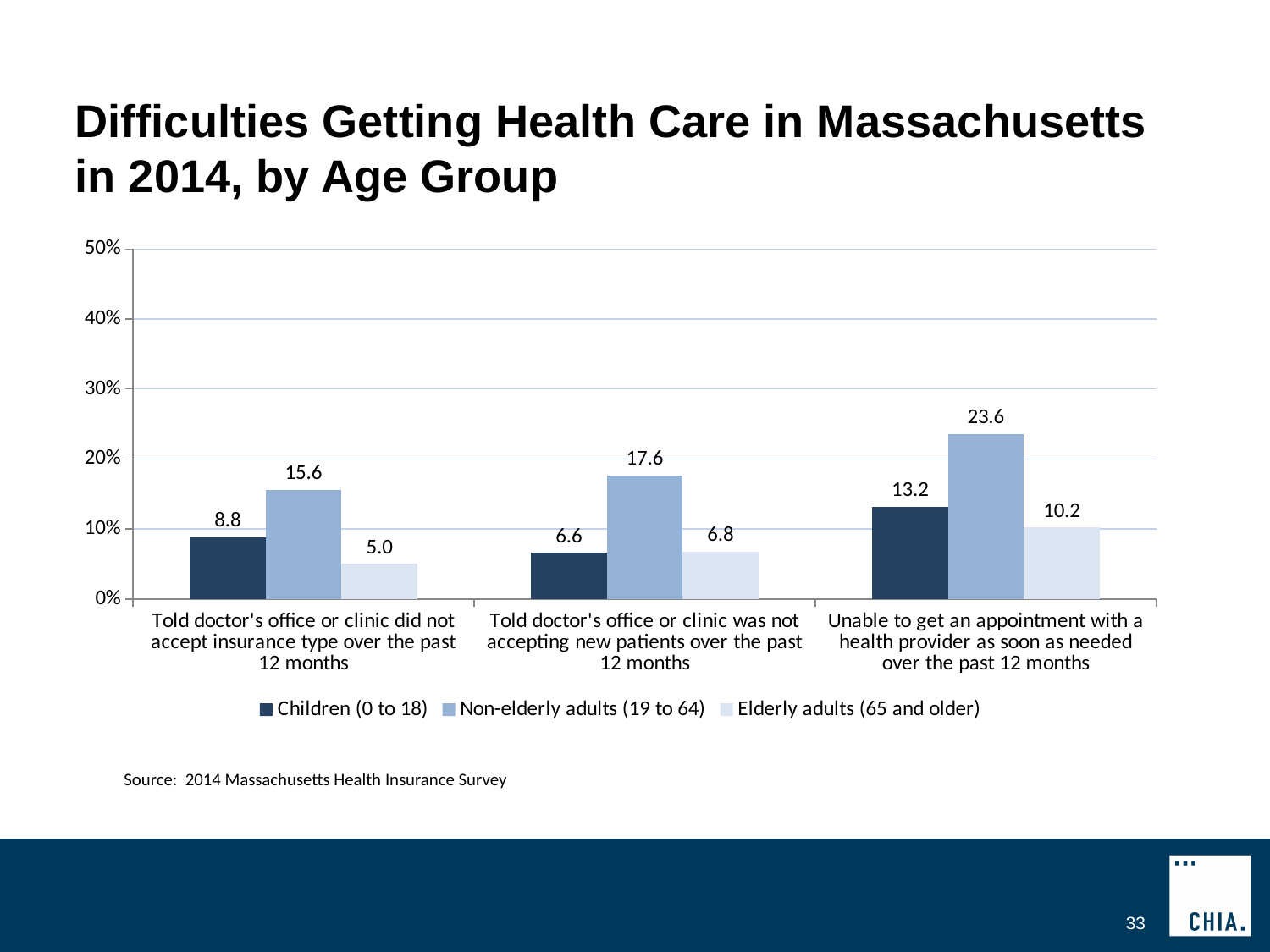
Which age group has the lowest value for 'Told doctor's office or clinic did not accept insurance type over the past 12 months'? Elderly adults (65 and older) Which age group has the highest value for 'Told doctor's office or clinic was not accepting new patients over the past 12 months'? Non-elderly adults (19 to 64) How many categories of difficulty are shown on the x axis? 3 What is the value for Children (0 to 18) for 'Told doctor's office or clinic did not accept insurance type over the past 12 months'? 8.8 What kind of chart is shown on the slide? Bar chart What is the title of the chart? Difficulties Getting Health Care in Massachusetts in 2014, by Age Group What is the difference between the Non-elderly adults (19 to 64) and Children (0 to 18) values for 'Unable to get an appointment with a health provider as soon as needed over the past 12 months'? 10.4 What is the value for Elderly adults (65 and older) for 'Told doctor's office or clinic was not accepting new patients over the past 12 months'? 6.8 For Children (0 to 18), which is larger: the value for 'Told doctor's office or clinic did not accept insurance type' or 'Told doctor's office or clinic was not accepting new patients'? Told doctor's office or clinic did not accept insurance type What is the value for Non-elderly adults (19 to 64) for 'Unable to get an appointment with a health provider as soon as needed over the past 12 months'? 23.6 Is the value for Non-elderly adults (19 to 64) for 'Unable to get an appointment with a health provider as soon as needed over the past 12 months' greater or less than 20%? greater How many series does the legend list? 3